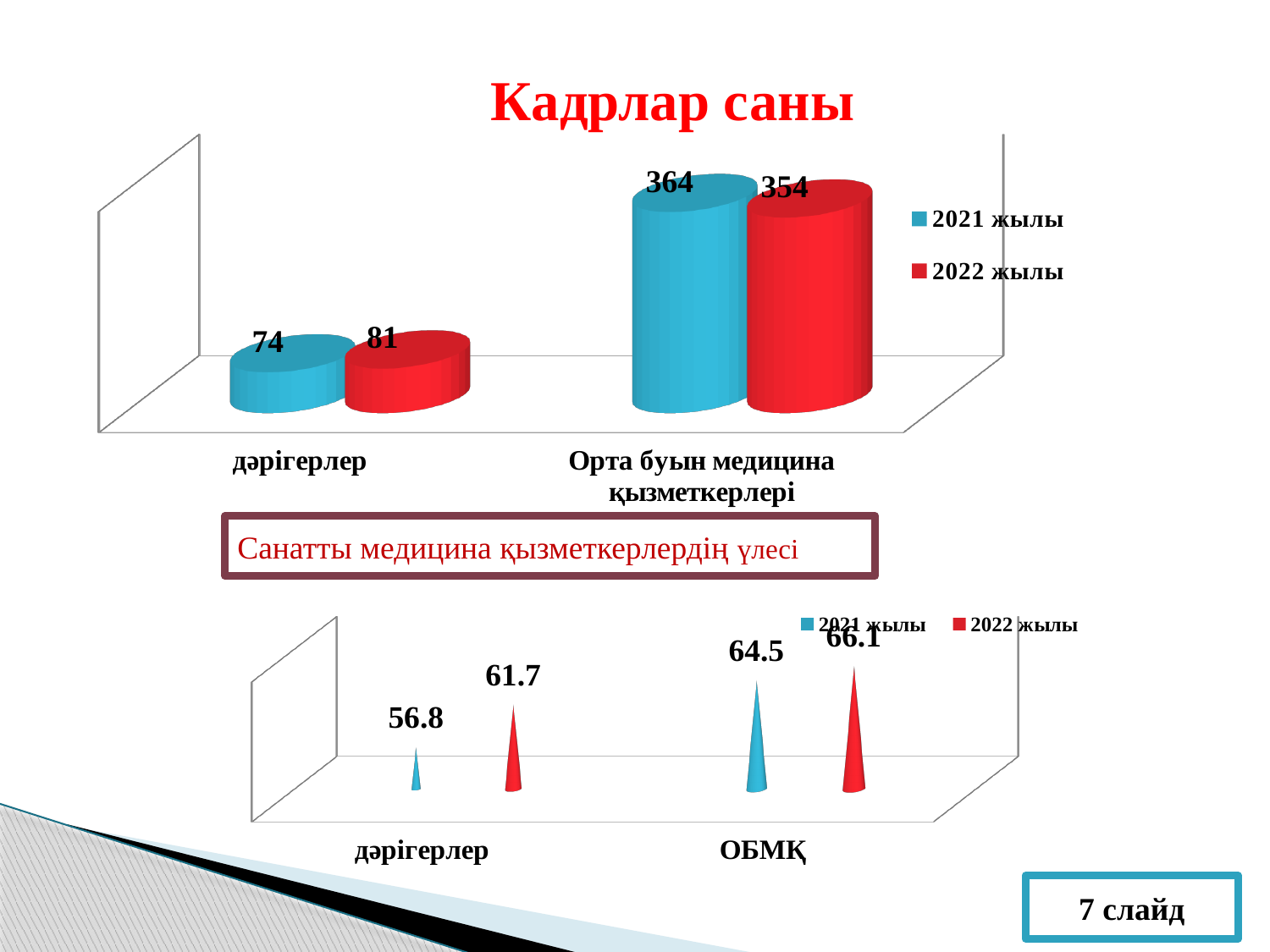
How many categories are shown on the x axis of the bottom chart (Санатты медицина қызметкерлердің үлесі)? 2 In the top chart (Кадрлар саны), what is the difference between the 2021 жылы and 2022 жылы values for дәрігерлер? 7 In the top chart (Кадрлар саны), which category has the highest value in 2021 жылы? Орта буын медицина қызметкерлері In the top chart (Кадрлар саны), what is the value for Орта буын медицина қызметкерлері in 2022 жылы? 354 In the top chart (Кадрлар саны), what is the value for дәрігерлер in 2021 жылы? 74 How many series does the legend of the top chart (Кадрлар саны) list? 2 In the top chart (Кадрлар саны), which is larger for Орта буын медицина қызметкерлері: the 2021 жылы value or the 2022 жылы value? 2021 жылы In the bottom chart (Санатты медицина қызметкерлердің үлесі), what is the value for дәрігерлер in 2022 жылы? 61.7 In the bottom chart (Санатты медицина қызметкерлердің үлесі), what is the value for ОБМҚ in 2021 жылы? 64.5 In the bottom chart (Санатты медицина қызметкерлердің үлесі), what is the difference between the 2022 жылы and 2021 жылы values for ОБМҚ? 1.6 What kind of chart is the top chart (Кадрлар саны)? Bar chart In the bottom chart (Санатты медицина қызметкерлердің үлесі), which category has the lowest value in 2021 жылы? дәрігерлер